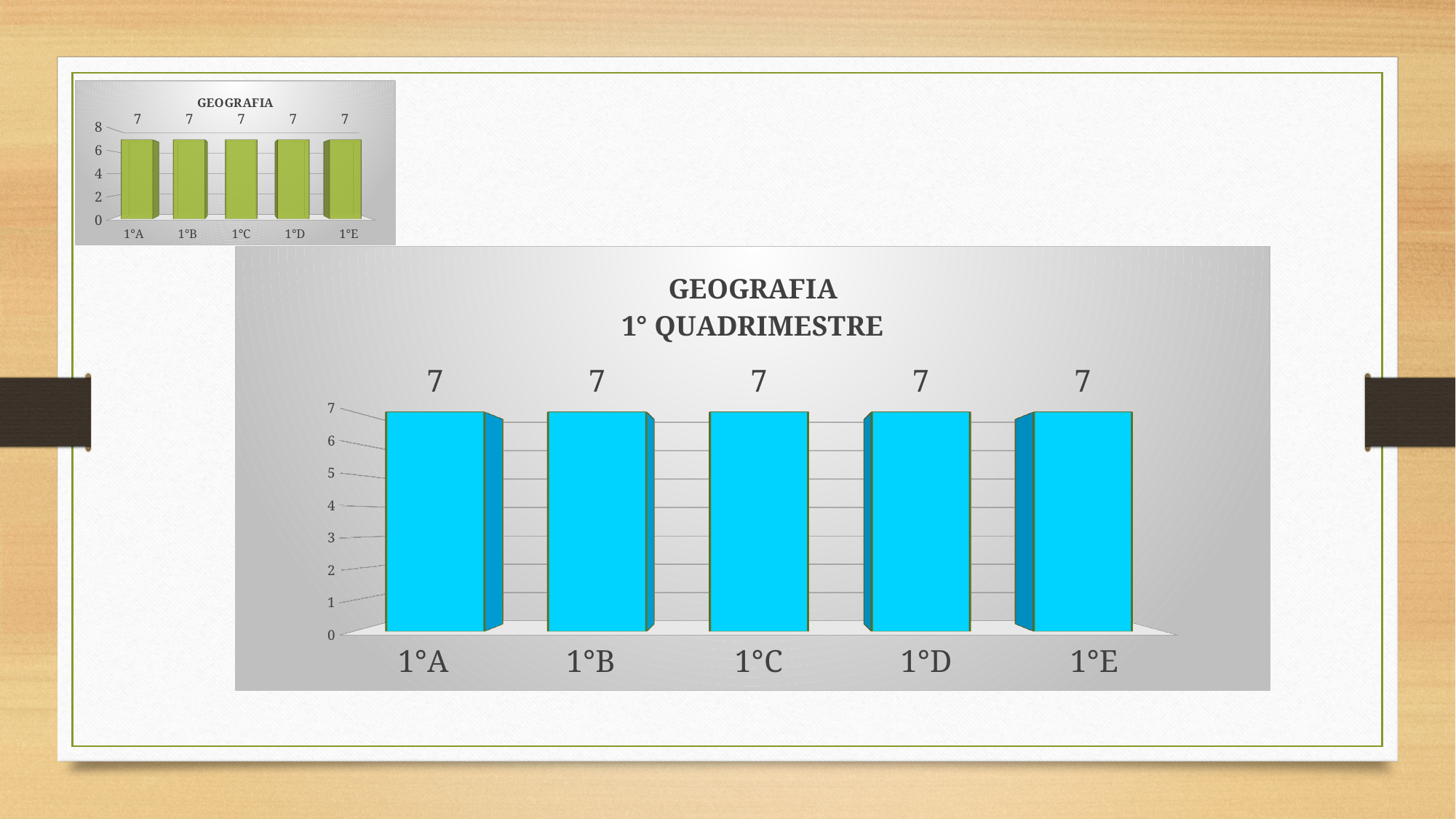
In the large chart titled "GEOGRAFIA 1° QUADRIMESTRE", what is the value for 1°A? 7 In the large chart titled "GEOGRAFIA 1° QUADRIMESTRE", do the values rise, fall, or stay the same from 1°A to 1°E? Stay the same In the large chart titled "GEOGRAFIA 1° QUADRIMESTRE", what is the difference between the values for 1°B and 1°E? 0 In the small chart at the top left titled "GEOGRAFIA", is the value for 1°B greater or less than 8? less In the small chart at the top left titled "GEOGRAFIA", what is the value for 1°E? 7 In the large chart titled "GEOGRAFIA 1° QUADRIMESTRE", is the value for 1°C greater or less than 5? greater In the large chart titled "GEOGRAFIA 1° QUADRIMESTRE", how many categories are shown on the x axis? 5 In the small chart at the top left titled "GEOGRAFIA", what is the value for 1°C? 7 In the small chart at the top left titled "GEOGRAFIA", how many bars are plotted? 5 What kind of chart is the large chart titled "GEOGRAFIA 1° QUADRIMESTRE"? Bar chart What colour are the bars in the large chart titled "GEOGRAFIA 1° QUADRIMESTRE"? Blue In the large chart titled "GEOGRAFIA 1° QUADRIMESTRE", what is the value for 1°D? 7